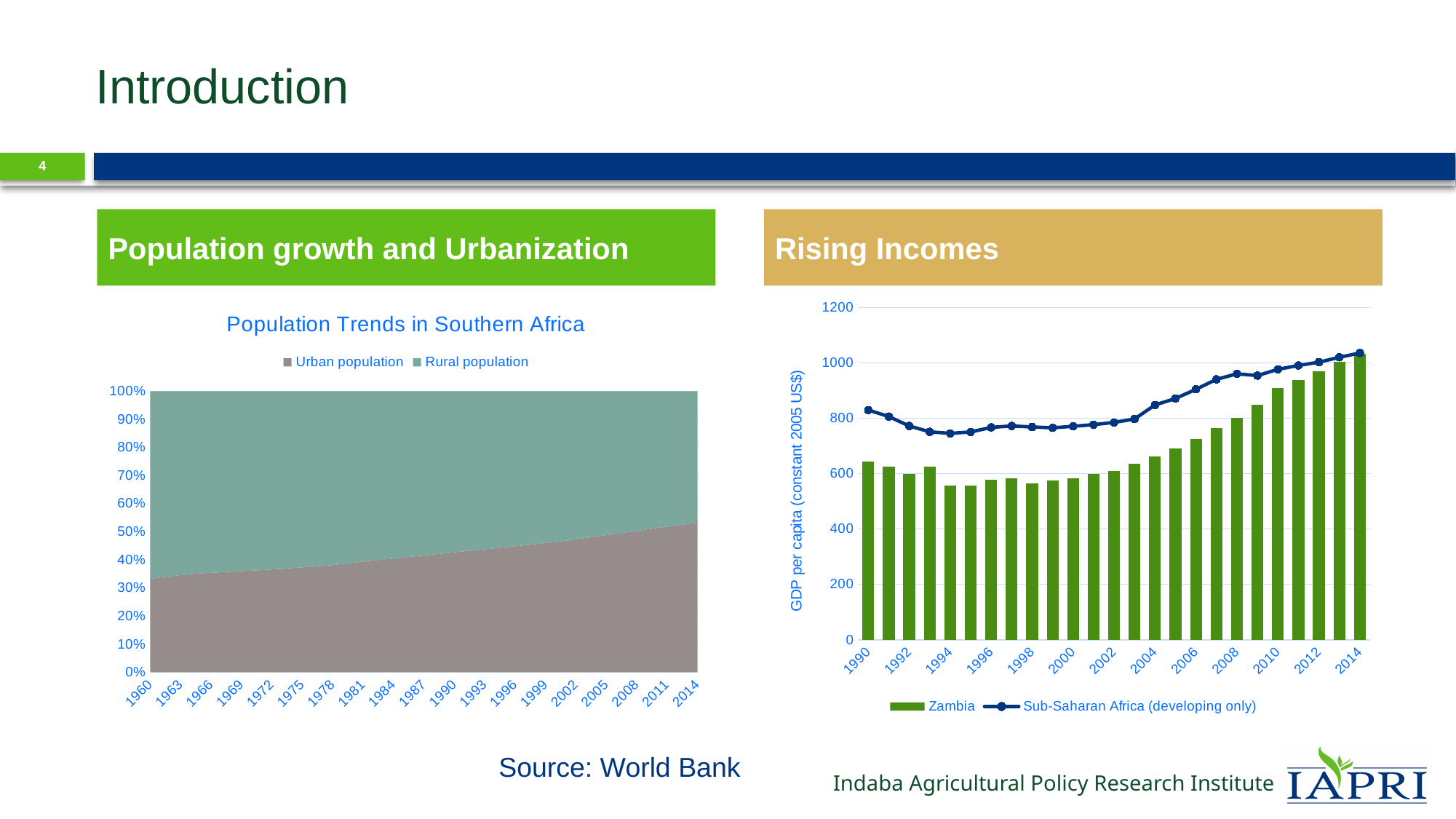
How many year labels are shown on the x axis of the 'Population Trends in Southern Africa' chart? 19 What is the y-axis label of the 'Rising Incomes' chart? GDP per capita (constant 2005 US$) In the 'Rising Incomes' chart, which is larger in 1990: the Zambia bar or the Sub-Saharan Africa (developing only) line? Sub-Saharan Africa (developing only) In the 'Rising Incomes' chart, is the Zambia value for 1994 greater or less than 600? less In the 'Population Trends in Southern Africa' chart, does the urban population share rise or fall from 1960 to 2014? rise How many series does the legend of the 'Population Trends in Southern Africa' chart list? 2 In the 'Rising Incomes' chart, which year has the highest Zambia bar? 2014 In the 'Rising Incomes' chart, is the Zambia value for 2014 greater or less than 1000? greater In the 'Rising Incomes' chart on the right, which series is drawn as a line? Sub-Saharan Africa (developing only) What kind of chart is the 'Population Trends in Southern Africa' chart on the left? stacked area chart In the 'Population Trends in Southern Africa' chart, is the urban population share in 2014 greater or less than 50%? greater